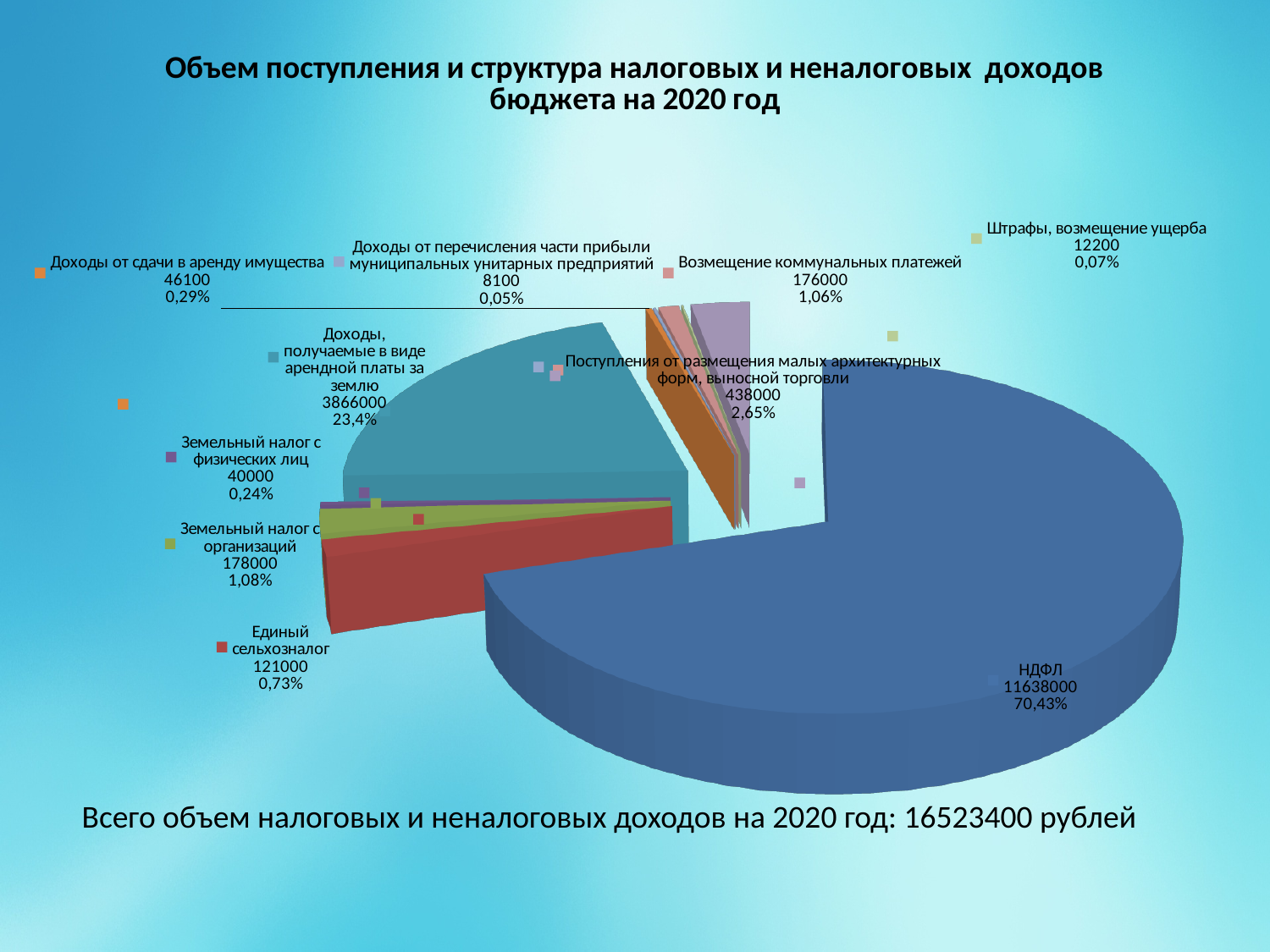
What is the value for Штрафы, возмещение ущерба? 12200 What kind of chart is shown on the slide? Pie chart Which category has the largest slice of the pie? НДФЛ What is the difference between the values for Земельный налог с организаций and Возмещение коммунальных платежей? 2000 Which category has the smallest slice of the pie? Доходы от перечисления части прибыли муниципальных унитарных предприятий What share of the pie does Поступления от размещения малых архитектурных форм, выносной торговли represent? 2,65% How many categories are shown in the pie chart? 10 What is the value for НДФЛ? 11638000 According to the text below the chart, what is the total volume of tax and non-tax revenues for 2020? 16523400 рублей Which is larger: the value for Единый сельхозналог or the value for Доходы от сдачи в аренду имущества? Единый сельхозналог What share of the pie does НДФЛ represent? 70,43% What is the value for Доходы, получаемые в виде арендной платы за землю? 3866000